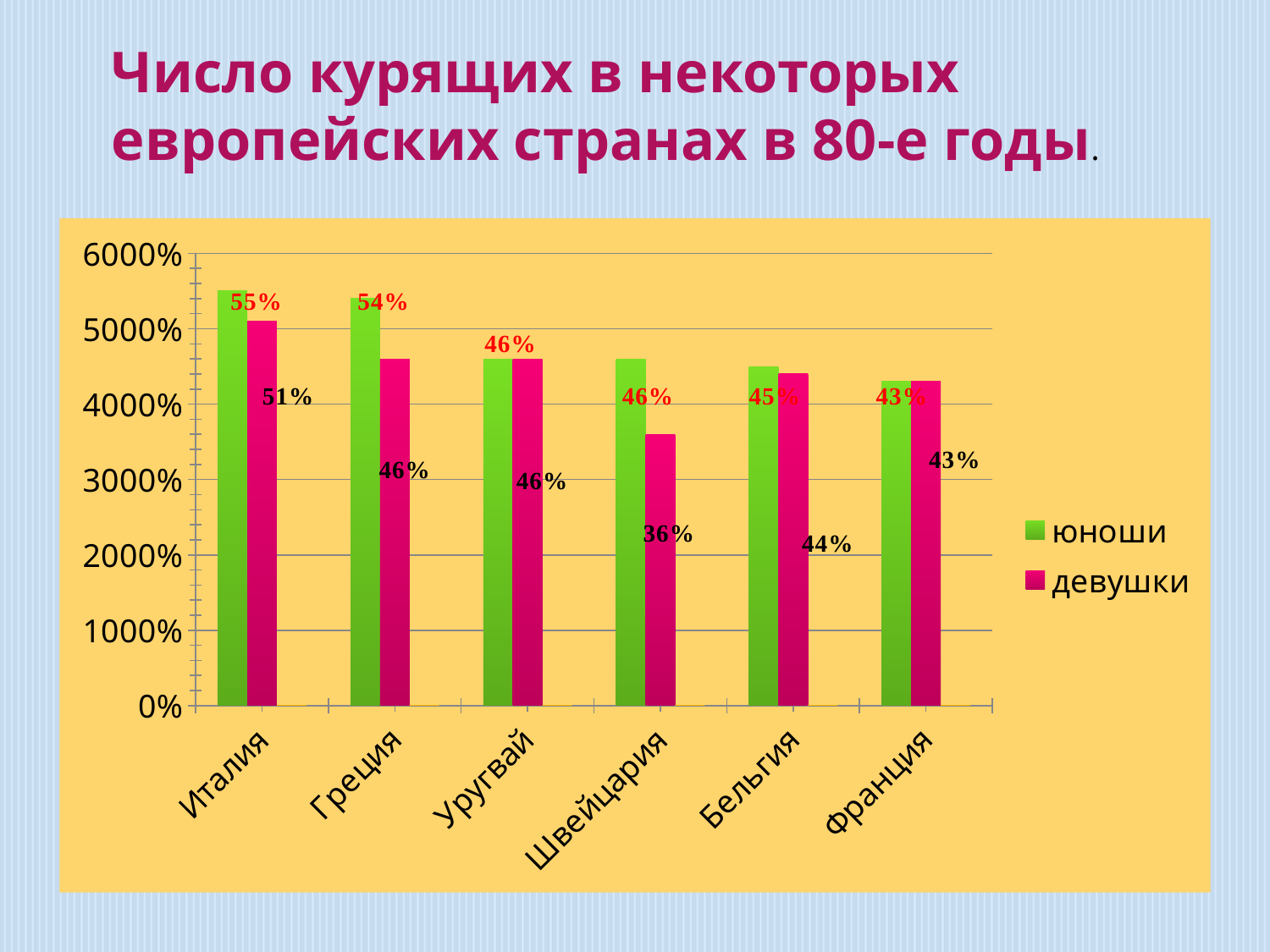
What is the value for девушки in Швейцария? 36% What is the value for девушки in Бельгия? 44% Which country has the highest value for юноши? Италия How many series does the legend list? 2 What is the value for юноши in Греция? 54% What kind of chart is shown on the slide? bar chart Do the values for юноши rise or fall from Италия to Франция along the x axis? fall In Швейцария, which is larger: the value for юноши or for девушки? юноши Which country has the lowest value for девушки? Швейцария What is the value for юноши in Италия? 55% What is the difference between the юноши and девушки values in Италия? 4% How many countries are shown on the x axis? 6